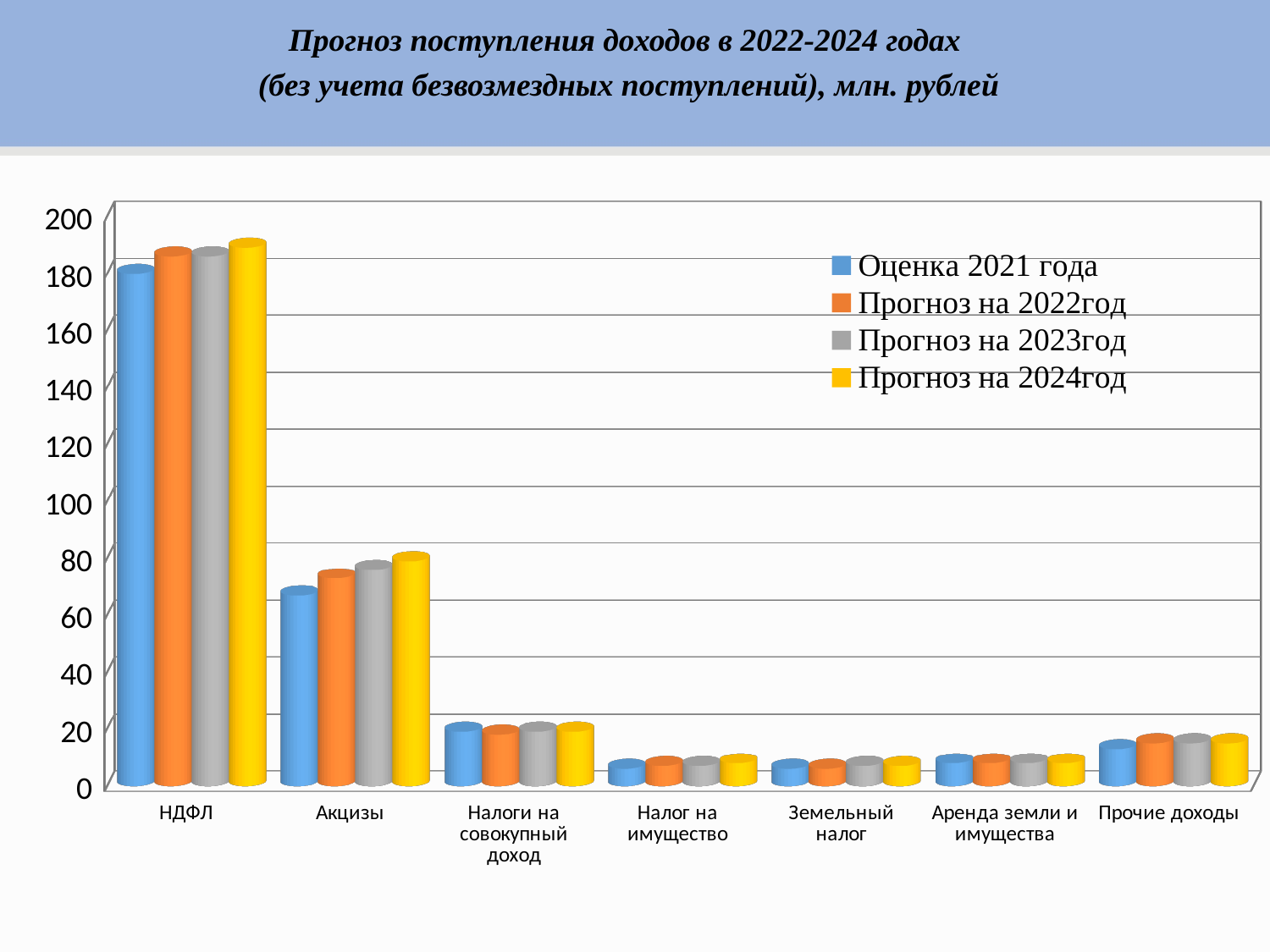
For Прогноз на 2024год, which is larger: НДФЛ or Акцизы? НДФЛ What kind of chart is shown on the slide? bar chart How many series does the legend list? 4 Is the value for Прочие доходы in Прогноз на 2022год greater or less than 20? less Which category has the highest value for Прогноз на 2024год? НДФЛ How many categories are shown on the x axis? 7 Is the value for Налоги на совокупный доход in Оценка 2021 года greater or less than 40? less Is the value for Акцизы in Оценка 2021 года greater or less than 60? greater Which category has the highest value for Оценка 2021 года? НДФЛ For Акцизы, which is larger: Оценка 2021 года or Прогноз на 2024год? Прогноз на 2024год